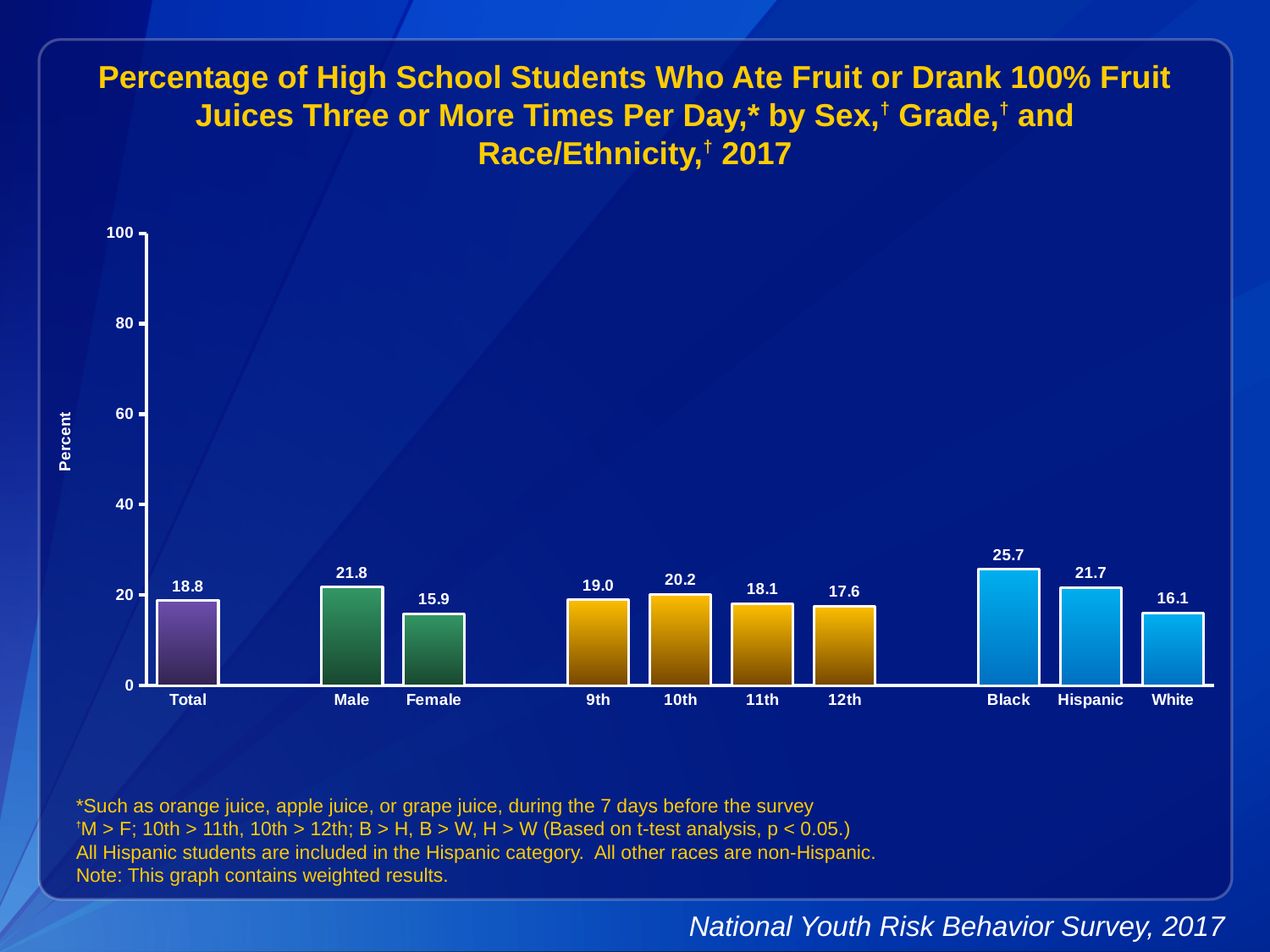
What is the value for Total? 18.8 What is the difference between the Male and Female values? 5.9 Which category has the highest value? Black Which category has the lowest value? Female What is the value for 10th grade? 20.2 How many categories are shown on the x axis? 10 What is the value for Female? 15.9 Which is larger, the value for 9th grade or 12th grade? 9th Is the value for Black greater or less than 20? greater What is the difference between the Black and White values? 9.6 What is the value for Hispanic students? 21.7 What kind of chart is this? Bar chart